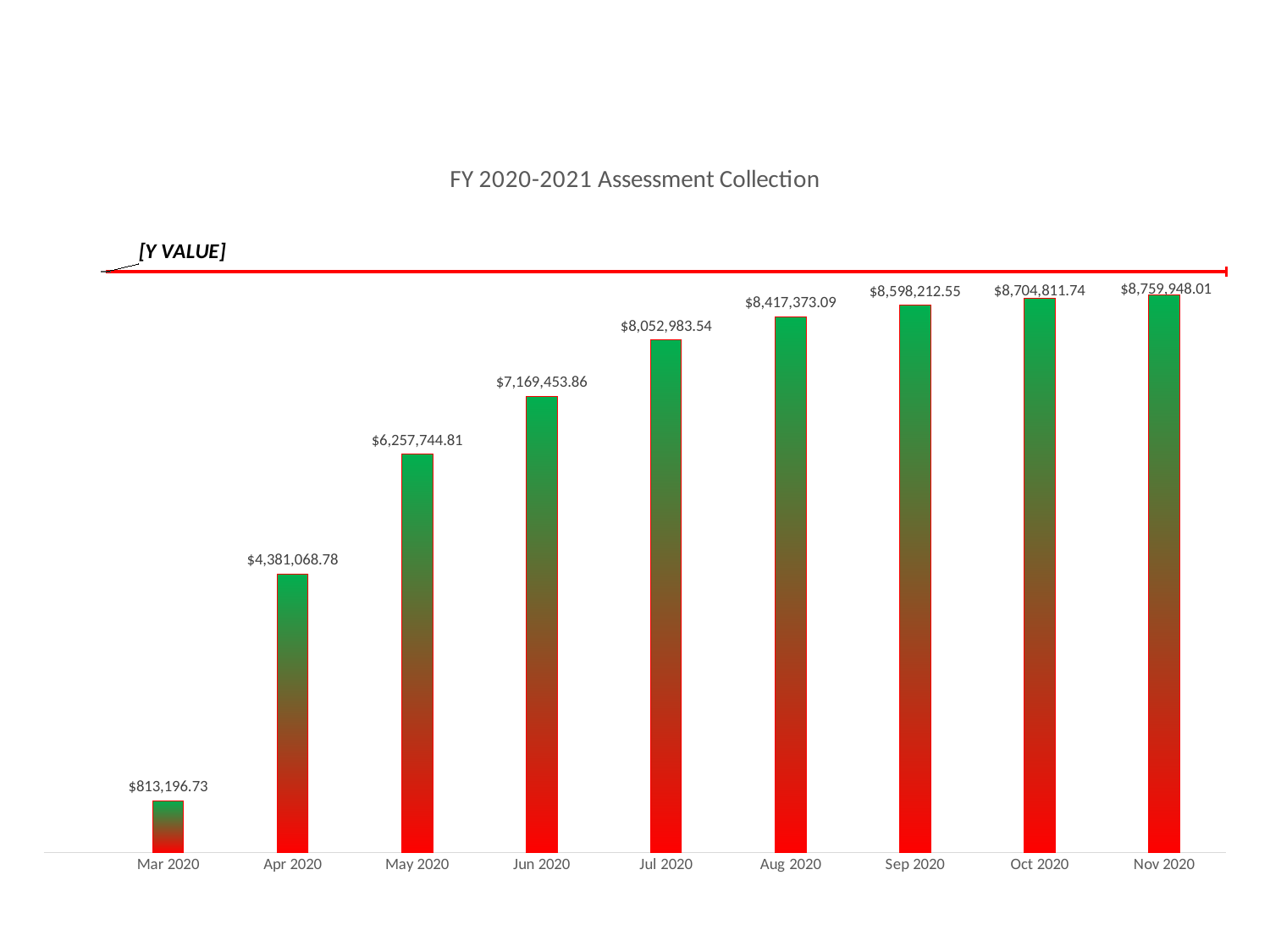
What is the value for Jun 2020? $7,169,453.86 What is the title of the chart? FY 2020-2021 Assessment Collection Which is larger, the value for May 2020 or the value for Jul 2020? Jul 2020 Do the values rise or fall from Mar 2020 to Nov 2020? Rise Which month has the highest value? Nov 2020 What type of chart is shown on the slide? Bar chart Which month has the lowest value? Mar 2020 What is the value for Sep 2020? $8,598,212.55 What is the difference between the values for Nov 2020 and Oct 2020? $55,136.27 What is the value for Mar 2020? $813,196.73 How many months are plotted on the x axis? 9 What is the difference between the values for Apr 2020 and Mar 2020? $3,567,872.05